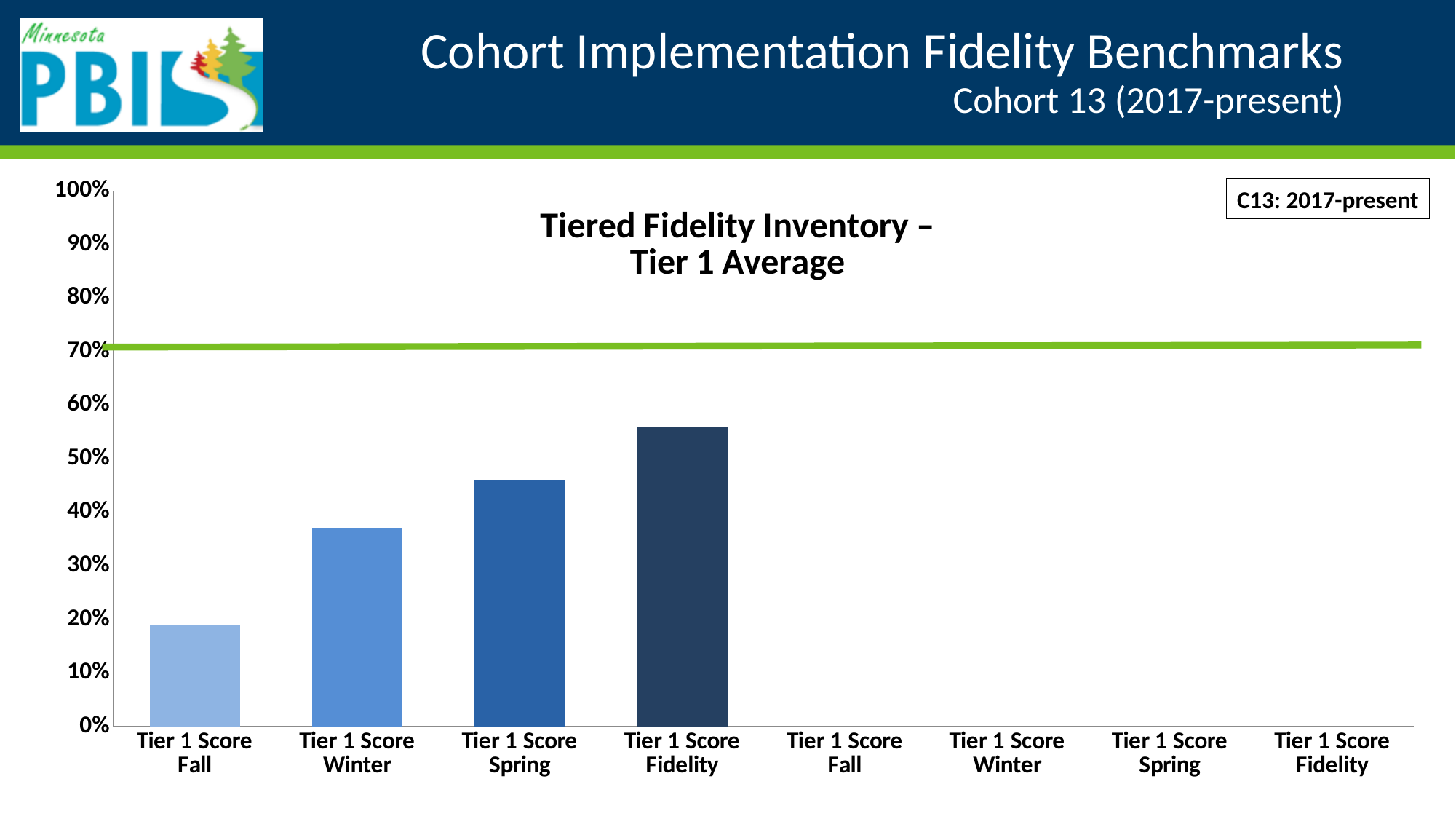
Is the value for Tier 1 Score Winter greater or less than 30%? greater Is the value for Tier 1 Score Fidelity greater or less than 60%? less Is the value for Tier 1 Score Spring greater or less than 50%? less What is the title of the chart? Tiered Fidelity Inventory – Tier 1 Average Which plotted bar has the highest value? Tier 1 Score Fidelity How many bars are plotted in the chart? 4 How many category labels are shown along the x axis? 8 Do the plotted bar values rise or fall from Tier 1 Score Fall to Tier 1 Score Fidelity? rise What kind of chart is shown on the slide? bar chart Which plotted bar has the lowest value? Tier 1 Score Fall Which is larger, the value for Tier 1 Score Winter or Tier 1 Score Spring? Tier 1 Score Spring